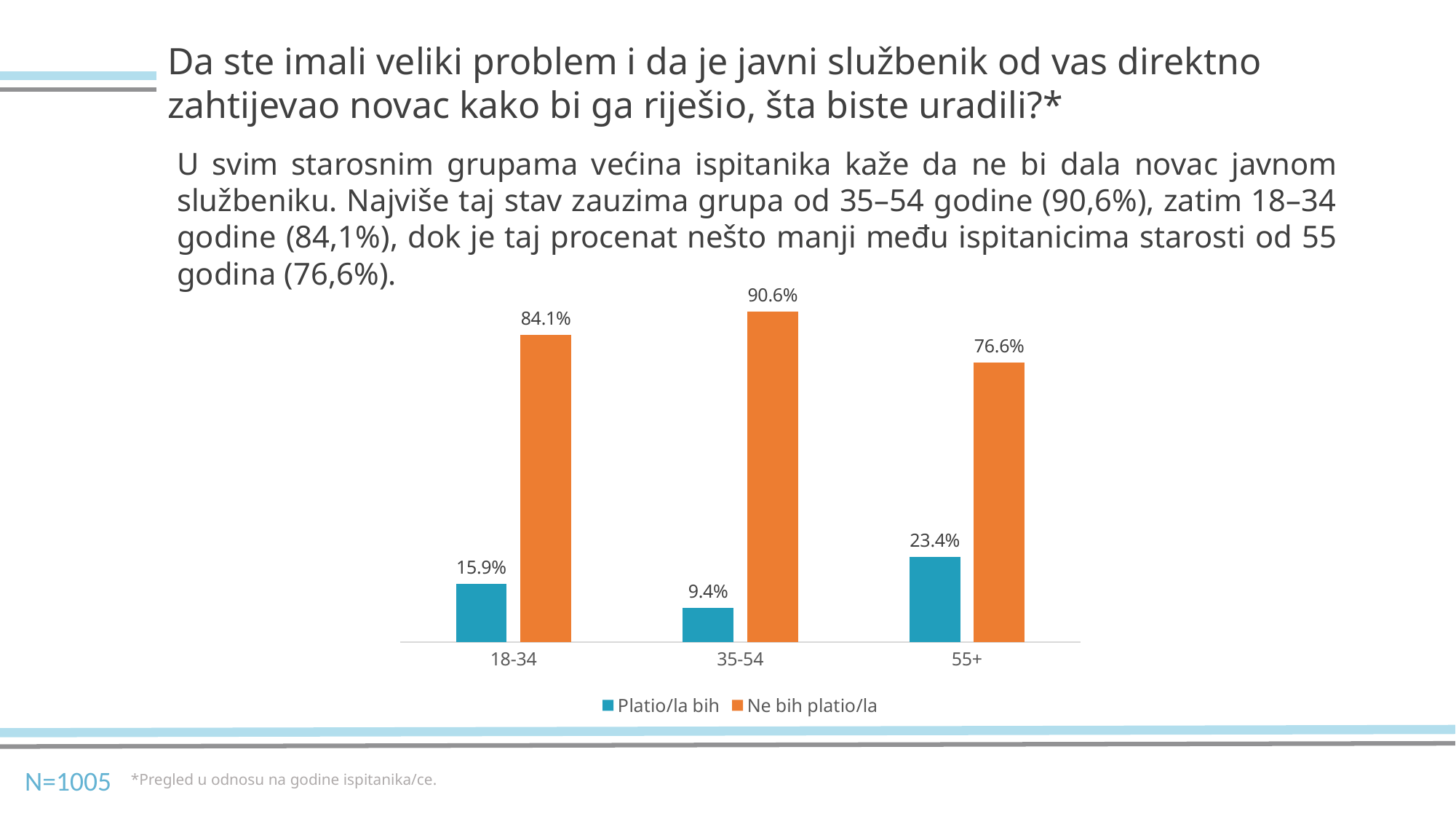
Which age group has the lowest value for 'Platio/la bih'? 35-54 What is the difference between the 'Ne bih platio/la' values for 35-54 and 18-34? 6.5% What is the difference between 'Ne bih platio/la' and 'Platio/la bih' in the 55+ age group? 53.2% What is the value for 'Platio/la bih' in the 18-34 age group? 15.9% What is the value for 'Ne bih platio/la' in the 35-54 age group? 90.6% Which age group has the highest value for 'Ne bih platio/la'? 35-54 What kind of chart is shown on the slide? Bar chart Which colour represents the 'Ne bih platio/la' series? Orange How many series does the legend list? 2 How many age groups are shown on the x axis? 3 What is the value for 'Platio/la bih' in the 55+ age group? 23.4% Which is larger: 'Platio/la bih' for 18-34 or 'Platio/la bih' for 55+? 55+